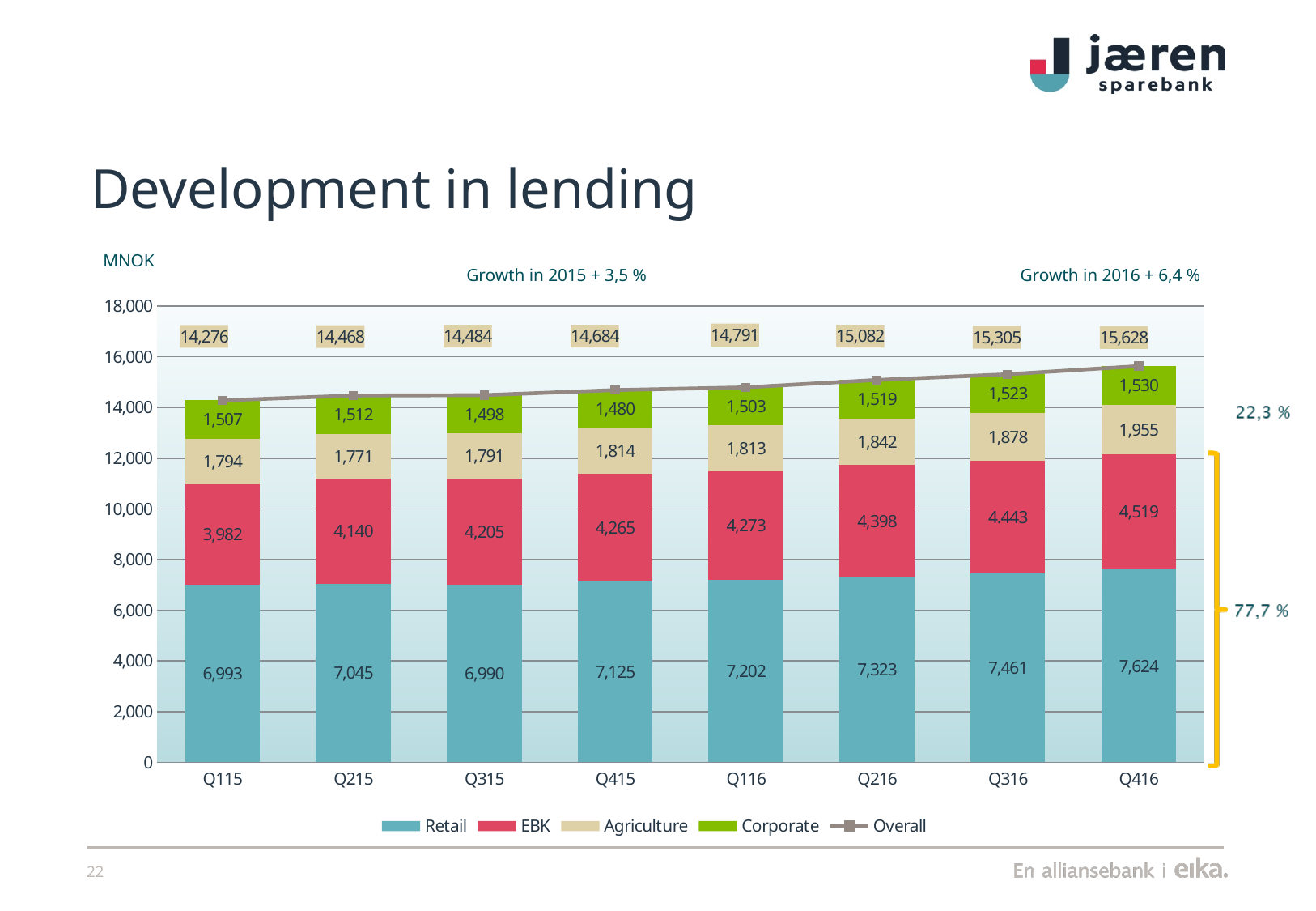
In which quarter is the Overall lending value highest? Q416 How many quarters are shown on the x axis? 8 Does the Overall lending value rise or fall from Q115 to Q416? Rise What is the EBK value for Q115? 3,982 In which quarter is the Retail value lowest? Q315 What is the Retail lending value for Q416? 7,624 What is the Overall lending value for Q216? 15,082 Which is larger, the Corporate value in Q115 or in Q415? Q115 How many series does the legend list? 5 What is the difference between the Overall value in Q416 and in Q115? 1,352 What kind of chart is shown on the slide? Stacked bar chart with a line What is the Agriculture value for Q316? 1,878